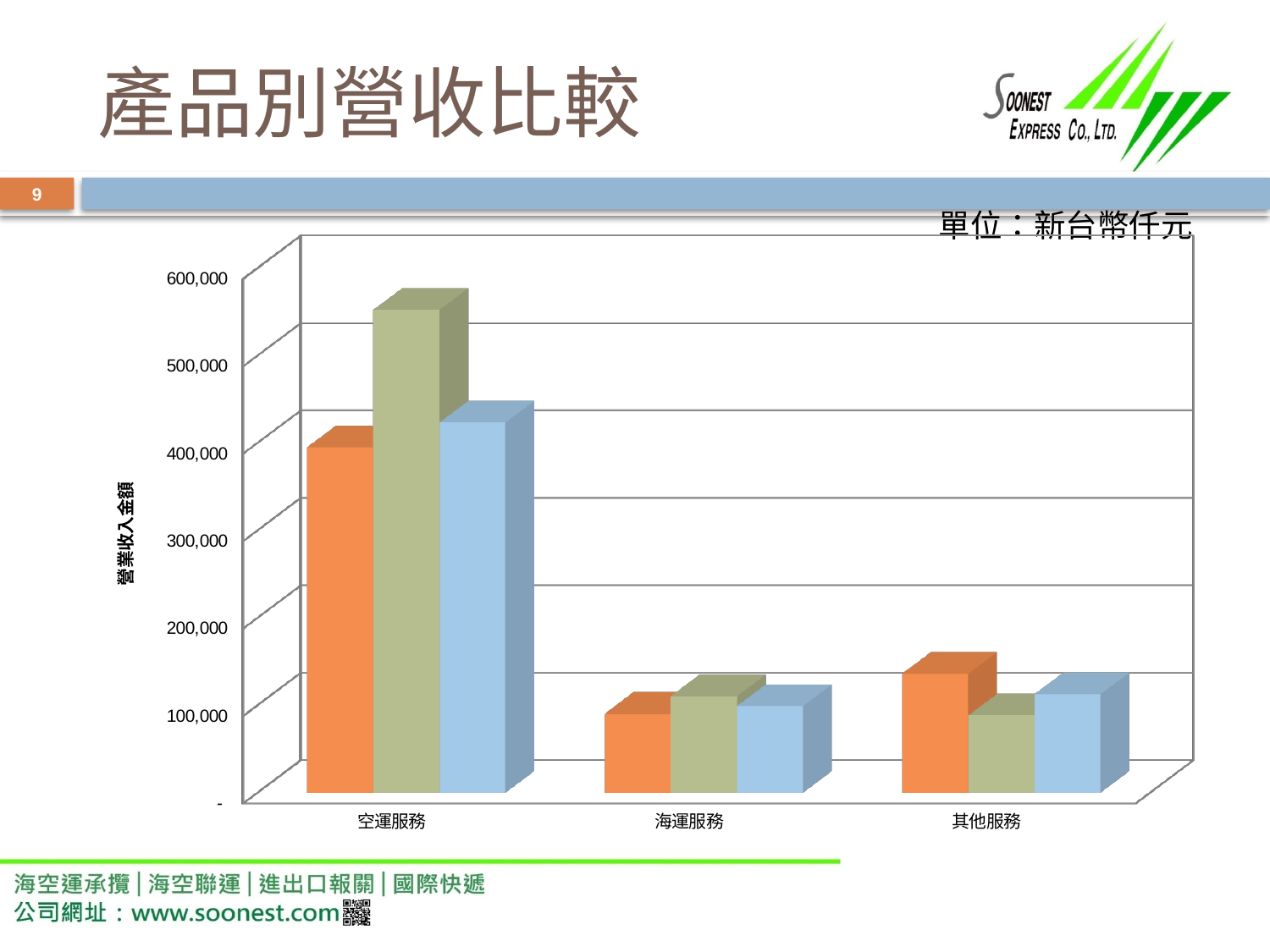
How many product categories are shown on the x axis of the chart? 3 Is the orange bar for 空運服務 greater or less than 500,000? less Within the 其他服務 category, which coloured bar is the tallest? orange Is the green bar for 其他服務 greater or less than 100,000? less How many bars are plotted for each category in the chart? 3 Within the 空運服務 category, which coloured bar is the tallest? green What kind of chart is shown on the slide? bar chart Is the orange bar for 其他服務 greater or less than 100,000? greater Which is larger, the green bar for 空運服務 or the green bar for 海運服務? 空運服務 Which category has the tallest bars in the chart? 空運服務 What unit is stated for the values in the chart? 新台幣仟元